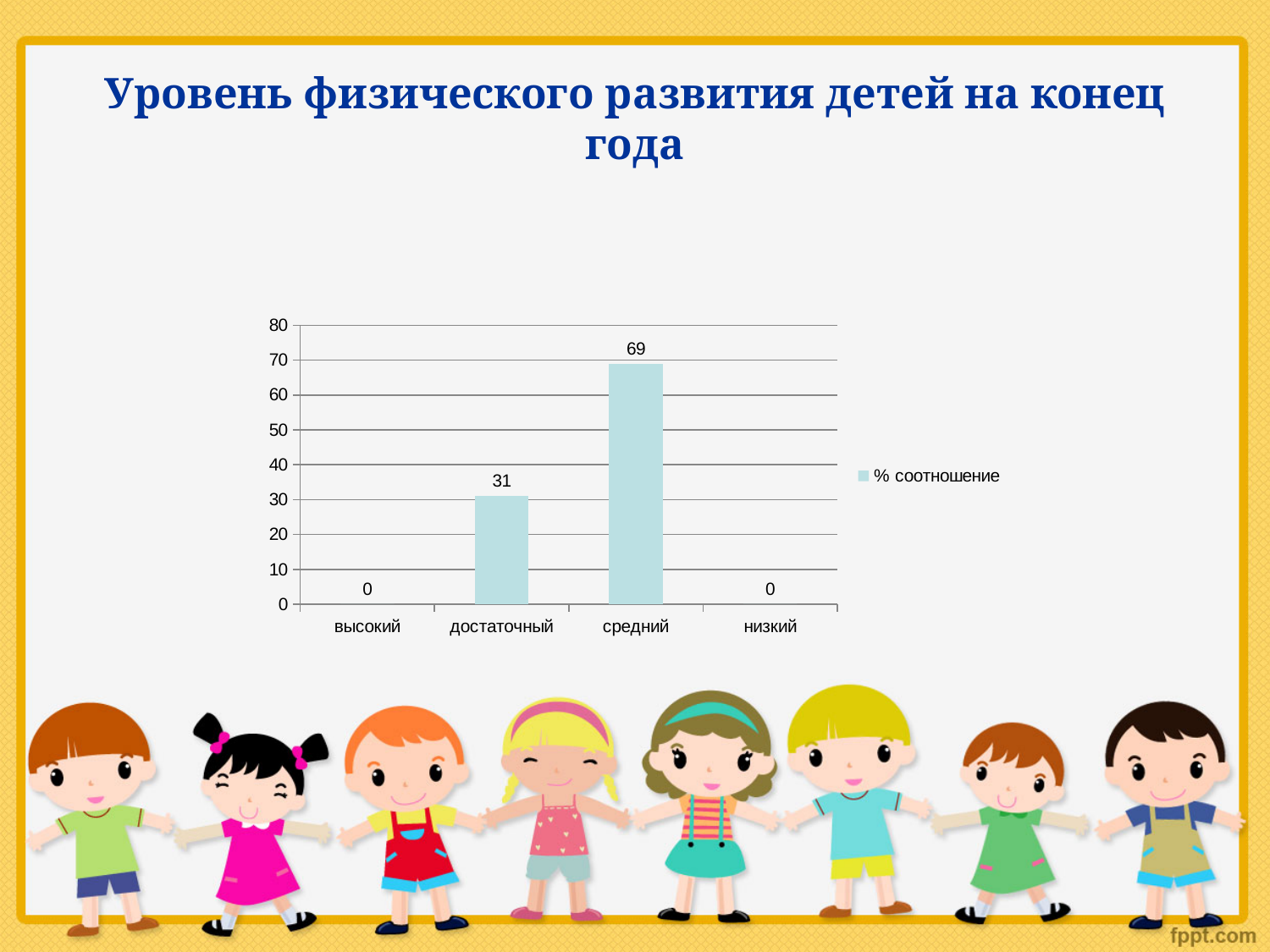
How many series does the legend list? 1 What is the value for низкий? 0 How many categories are shown on the x axis? 4 What kind of chart is shown on the slide? bar chart Is the value for средний greater or less than 60? greater What is the value for высокий? 0 What is the value for средний? 69 What is the difference between the values for средний and достаточный? 38 What is the value for достаточный? 31 Which is larger, the value for достаточный or the value for средний? средний What is the legend entry for the series? % соотношение Which category has the highest value? средний